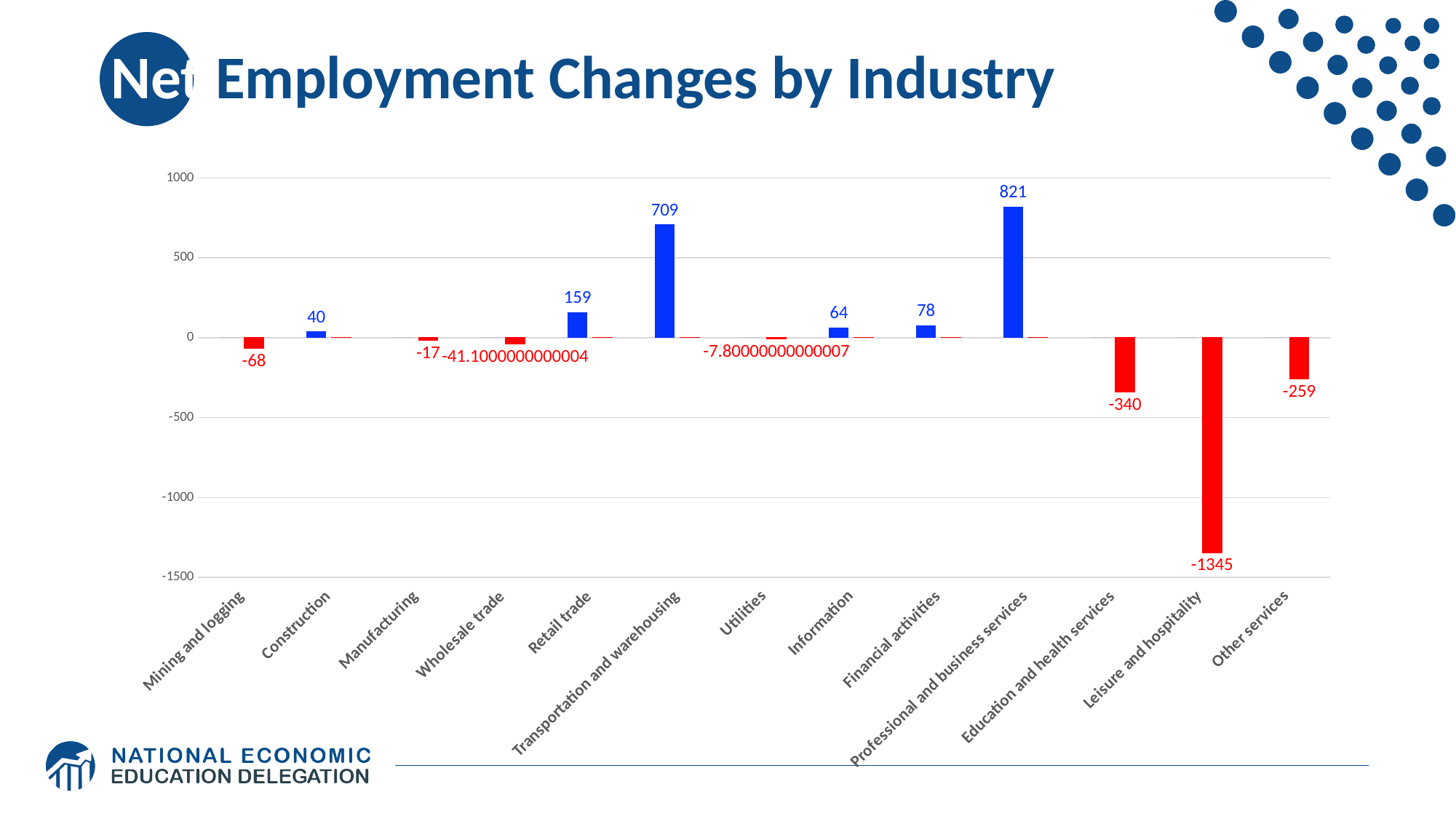
What is the employment change for Construction? 40 What is the difference between the employment change for Professional and business services and Transportation and warehousing? 112 How many industries are shown on the chart? 13 What colour are the bars with negative values? Red Which industry has the lowest employment change? Leisure and hospitality Which industry has the highest employment change? Professional and business services What is the employment change for Leisure and hospitality? -1345 Which has a larger employment change, Retail trade or Financial activities? Retail trade What is the employment change for Education and health services? -340 Is the value for Other services greater or less than -500? greater What is the employment change for Transportation and warehousing? 709 What kind of chart is shown on the slide? Bar chart